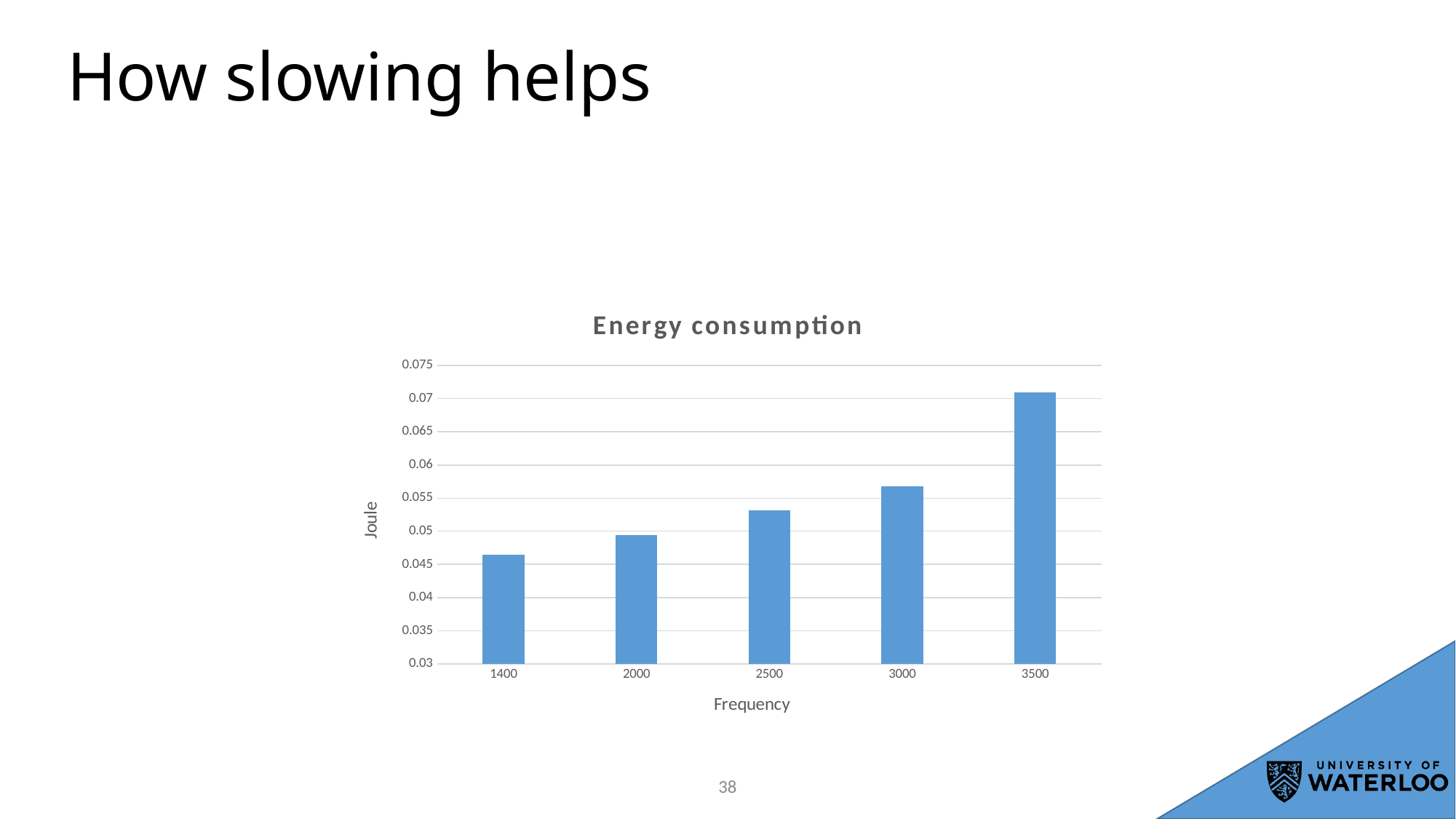
Which has the larger energy consumption, frequency 1400 or frequency 2500? 2500 Is the energy consumption for frequency 3000 greater or less than 0.055? greater How many frequency categories are plotted in the chart? 5 Which has the larger energy consumption, frequency 3000 or frequency 3500? 3500 Which frequency has the lowest energy consumption? 1400 Is the energy consumption for frequency 1400 greater or less than 0.05? less What kind of chart is shown on the slide? bar chart What is the label on the y axis of the chart? Joule What is the title of the chart? Energy consumption Do the energy consumption values rise or fall as frequency increases along the x axis? rise Which frequency has the highest energy consumption? 3500 Is the energy consumption for frequency 3500 greater or less than 0.065? greater